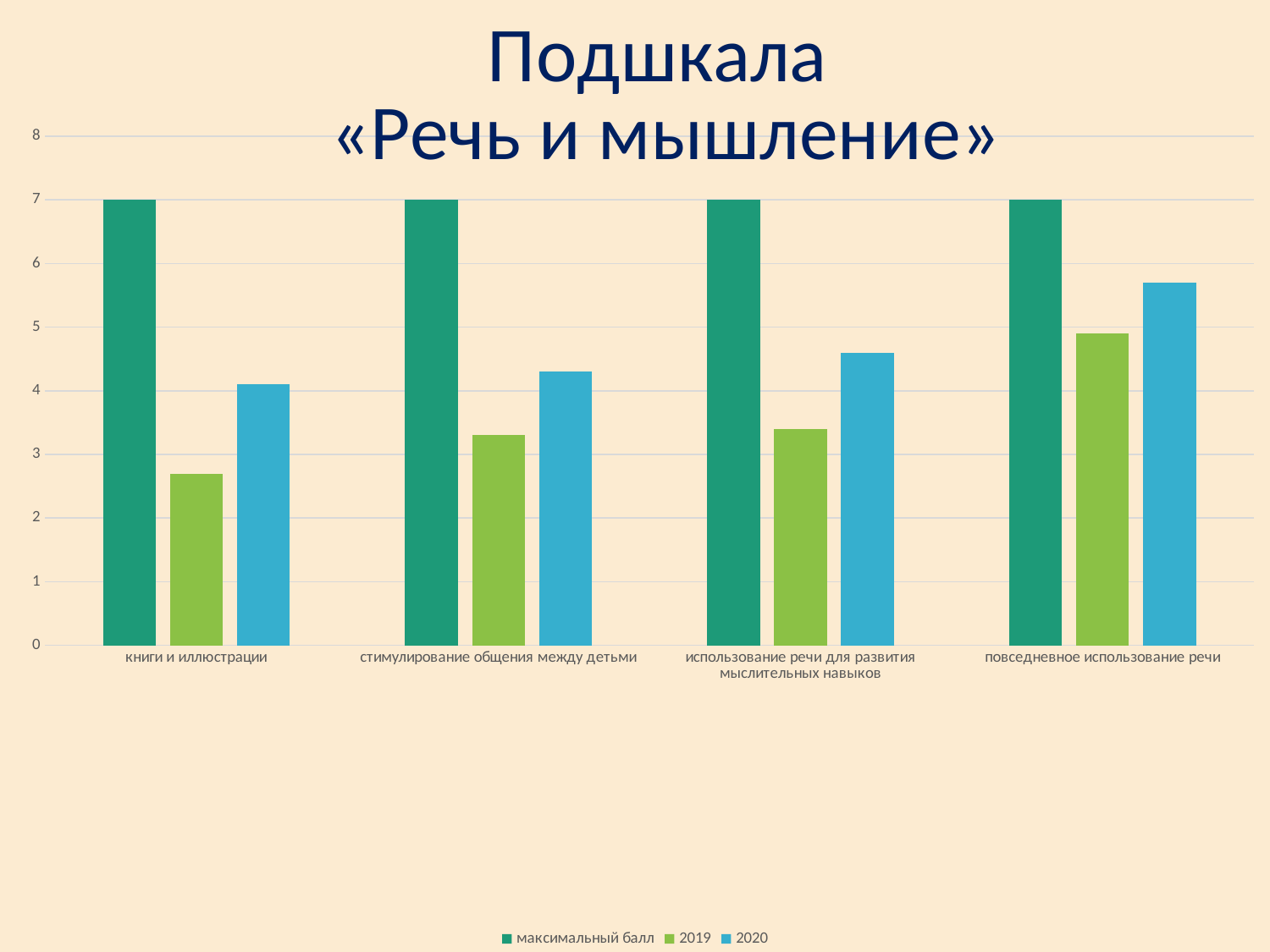
How many series does the legend list? 3 Is the 2020 value for «повседневное использование речи» greater or less than 5? greater How many categories are shown on the x axis? 4 For «стимулирование общения между детьми», which is larger: the 2019 value or the 2020 value? 2020 What is the title of the chart? Подшкала «Речь и мышление» What kind of chart is shown on the slide? bar chart Is the 2019 value for «использование речи для развития мыслительных навыков» greater or less than 4? less Is the 2019 value for «книги и иллюстрации» greater or less than 3? less Which category has the lowest 2019 value? книги и иллюстрации Do the 2019 values rise or fall from left to right across the categories? rise What is the value of «максимальный балл» for «книги и иллюстрации»? 7 Which category has the highest 2019 value? повседневное использование речи